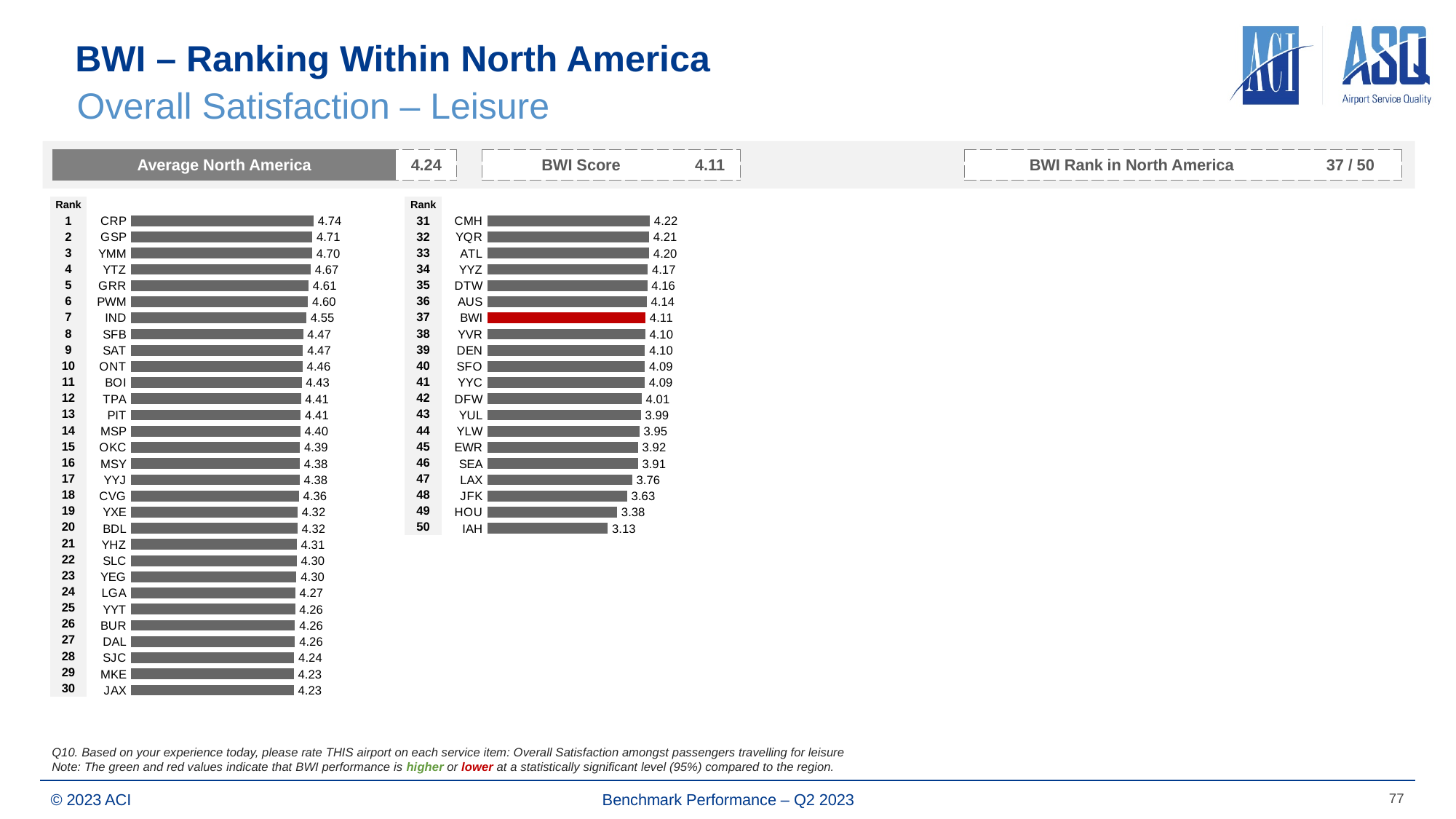
On the left chart (ranks 1-30), what is the value for CRP? 4.74 How many airports are plotted on the left chart (ranks 1-30)? 30 How many airports are plotted on the right chart (ranks 31-50)? 20 What kind of chart is used to show the airport rankings on this slide? Bar chart On the right chart (ranks 31-50), what is the difference between the values for CMH and BWI? 0.11 On the right chart (ranks 31-50), which airport has the lowest value? IAH On the right chart (ranks 31-50), which has the larger value, LAX or JFK? LAX On the right chart (ranks 31-50), what is the value for IAH? 3.13 On the right chart (ranks 31-50), what is the value for BWI? 4.11 On the right chart (ranks 31-50), which airport's bar is coloured red? BWI On the left chart (ranks 1-30), what is the difference between the values for CRP and JAX? 0.51 On the left chart (ranks 1-30), which airport has the highest value? CRP